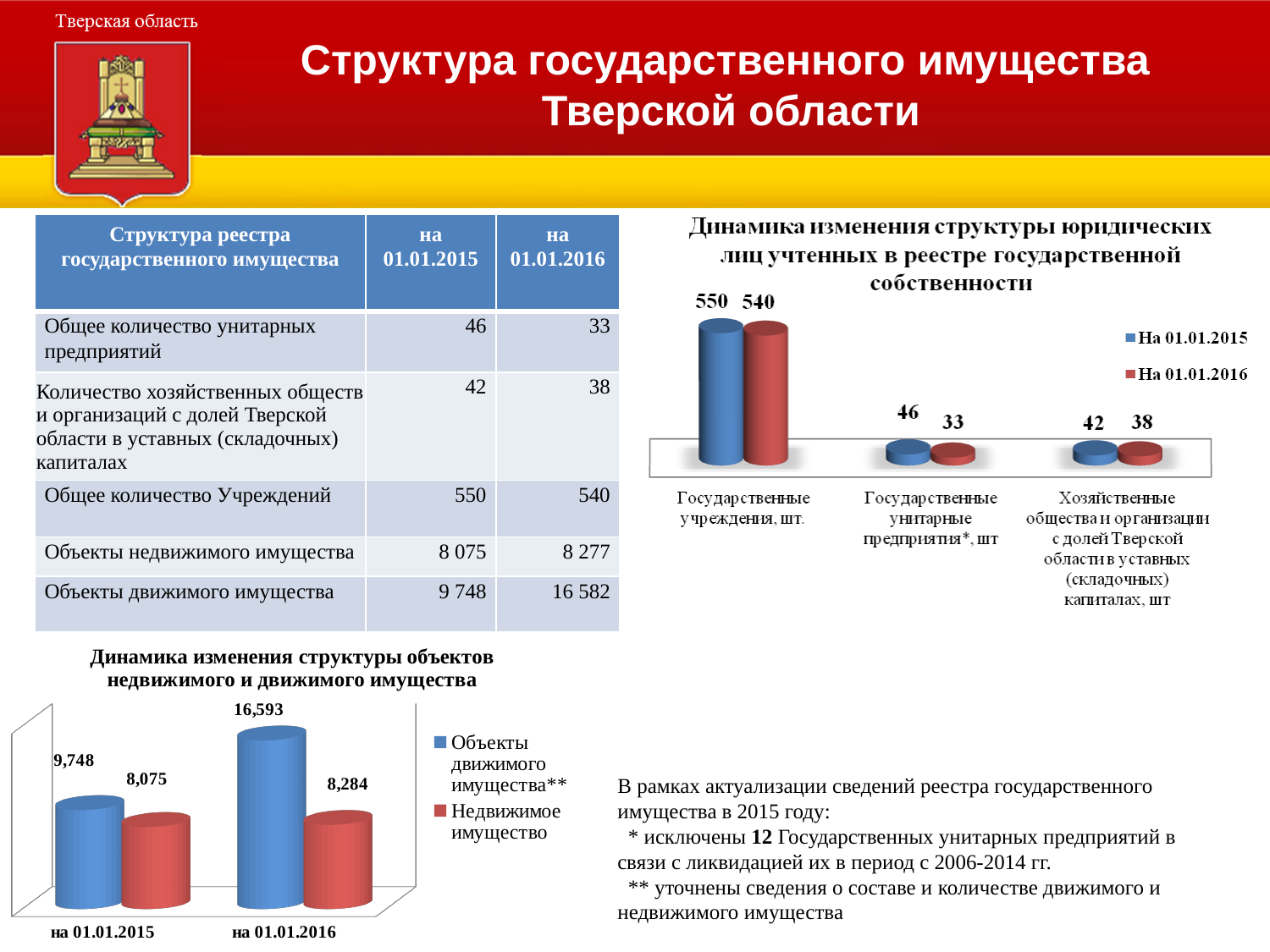
In the chart 'Динамика изменения структуры объектов недвижимого и движимого имущества', do the values for Объекты движимого имущества rise or fall from 01.01.2015 to 01.01.2016? rise What kind of chart is 'Динамика изменения структуры объектов недвижимого и движимого имущества'? bar chart In the chart 'Динамика изменения структуры объектов недвижимого и движимого имущества', what is the difference between Объекты движимого имущества and Недвижимое имущество on 01.01.2016? 8,309 In the chart 'Динамика изменения структуры юридических лиц учтенных в реестре государственной собственности', what is the difference between the 01.01.2015 and 01.01.2016 values for Государственные унитарные предприятия? 13 In the chart 'Динамика изменения структуры объектов недвижимого и движимого имущества', what is the value for Объекты движимого имущества on 01.01.2016? 16,593 In the chart 'Динамика изменения структуры объектов недвижимого и движимого имущества', what is the value for Недвижимое имущество on 01.01.2015? 8,075 In the chart 'Динамика изменения структуры юридических лиц учтенных в реестре государственной собственности', how many categories are shown on the x axis? 3 In the chart 'Динамика изменения структуры объектов недвижимого и движимого имущества', which is larger on 01.01.2015: Объекты движимого имущества or Недвижимое имущество? Объекты движимого имущества In the chart 'Динамика изменения структуры юридических лиц учтенных в реестре государственной собственности', what is the value for Государственные унитарные предприятия on 01.01.2016? 33 In the chart 'Динамика изменения структуры юридических лиц учтенных в реестре государственной собственности', which category has the highest values? Государственные учреждения, шт. In the chart 'Динамика изменения структуры юридических лиц учтенных в реестре государственной собственности', what is the value for Государственные учреждения on 01.01.2015? 550 In the chart 'Динамика изменения структуры юридических лиц учтенных в реестре государственной собственности', how many series does the legend list? 2